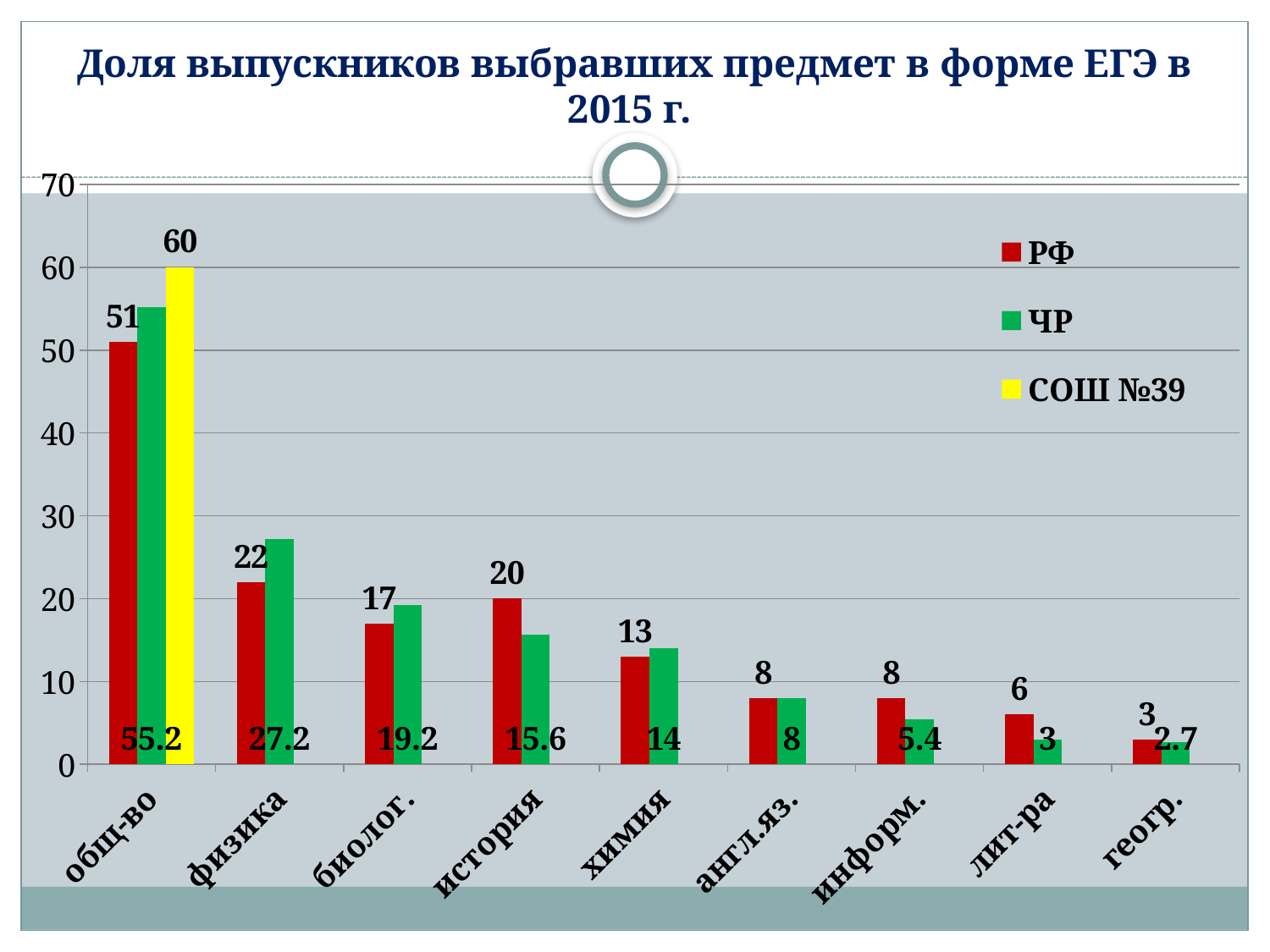
Which is larger for лит-ра: the РФ value or the ЧР value? РФ How many series does the legend list? 3 What type of chart is shown on the slide? bar chart Which series is shown in yellow in the legend? СОШ №39 How many subject categories are shown on the x axis? 9 Which subject has the highest value for РФ? общ-во What is the difference between the ЧР and РФ values for история? 4.4 What is the value for РФ for общ-во? 51 What is the value for ЧР for информ.? 5.4 Which subject has the lowest value for ЧР? геогр. What is the value for СОШ №39 for общ-во? 60 What is the value for ЧР for физика? 27.2